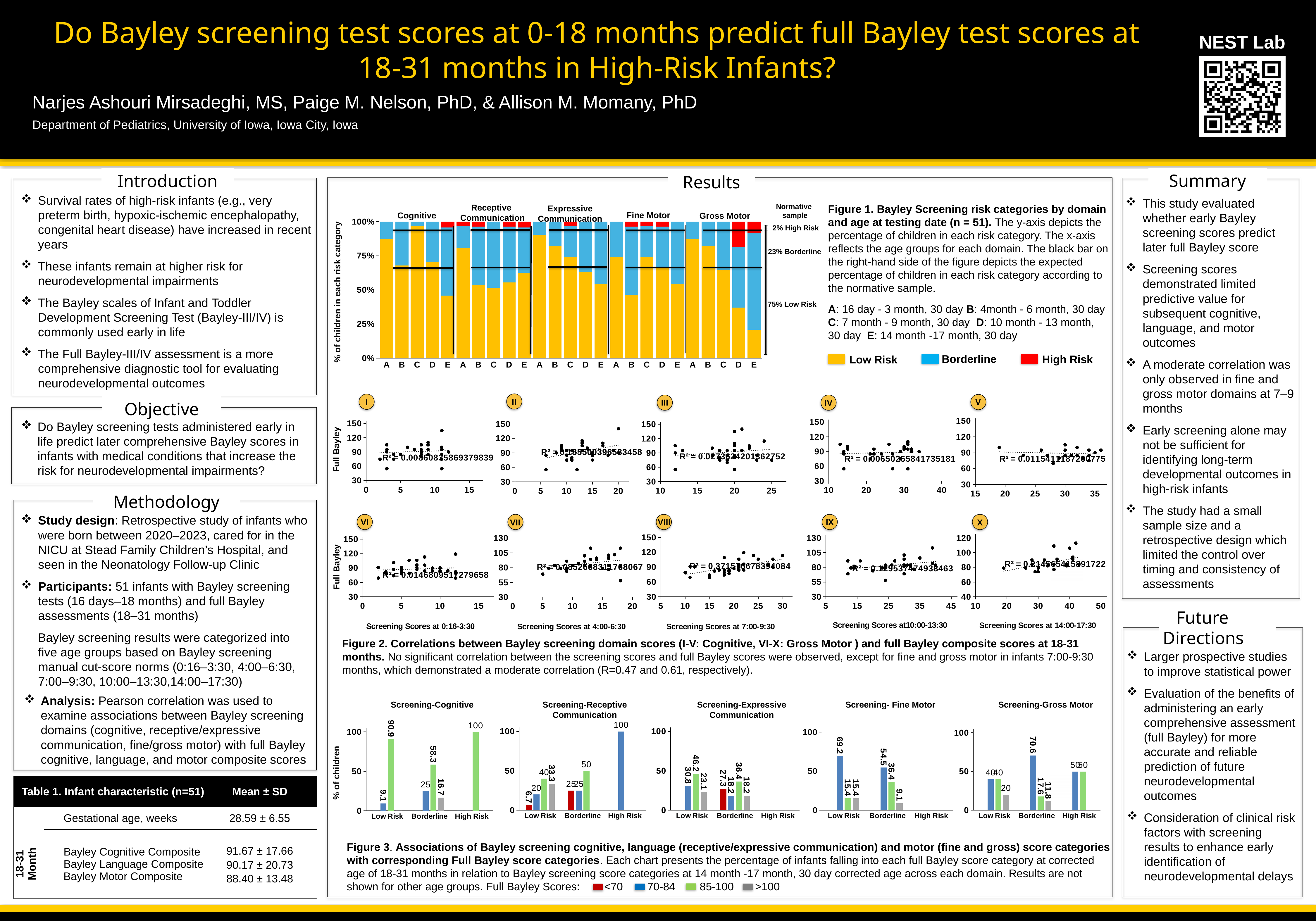
How many full Bayley score categories does the legend for Figure 3 list? 4 In the Screening-Receptive Communication chart, what is the value for the 70-84 category among High Risk infants? 100 In the Screening-Cognitive chart, what is the total of the three Borderline bars? 100 In Figure 1, how many age groups are shown for each domain? 5 In the Screening-Cognitive chart, what percentage of Low Risk infants had a full Bayley score of 85-100? 90.9 In the Screening- Fine Motor chart, what is the value for the 70-84 category among Low Risk infants? 69.2 In Figure 1, is the Low Risk percentage for Gross Motor age group D greater or less than 50%? less How many risk categories does the legend of Figure 1 list? 3 In the Screening- Fine Motor chart, which is larger for Borderline infants: the 70-84 value or the 85-100 value? 70-84 In the Screening-Gross Motor chart, what is the value for the 70-84 category among Borderline infants? 70.6 In the Screening-Expressive Communication chart, what is the difference between the 85-100 and 70-84 values for Low Risk infants? 15.4 What kind of chart is Figure 1? Stacked bar chart